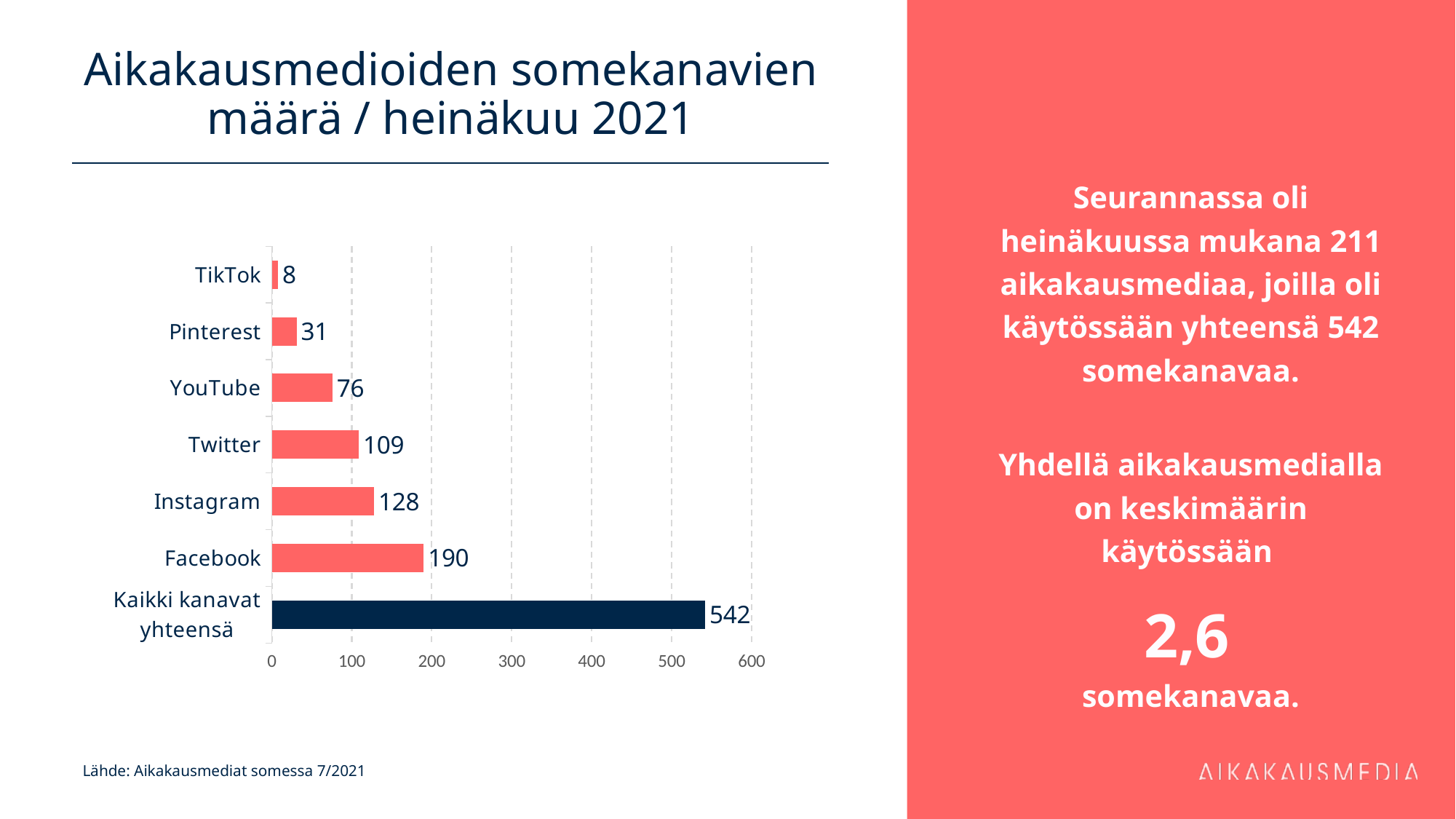
How many categories are shown in the chart? 7 Is the value for Pinterest greater or less than 100? less What kind of chart is shown on the slide? bar chart Which individual social media channel has the highest value? Facebook Which is larger, the value for Twitter or the value for YouTube? Twitter What is the title of the chart? Aikakausmedioiden somekanavien määrä / heinäkuu 2021 Which category has the lowest value? TikTok What is the value for Instagram? 128 What is the value for TikTok? 8 What is the difference between the values for Facebook and Instagram? 62 What is the value for Kaikki kanavat yhteensä? 542 What is the value for Facebook? 190